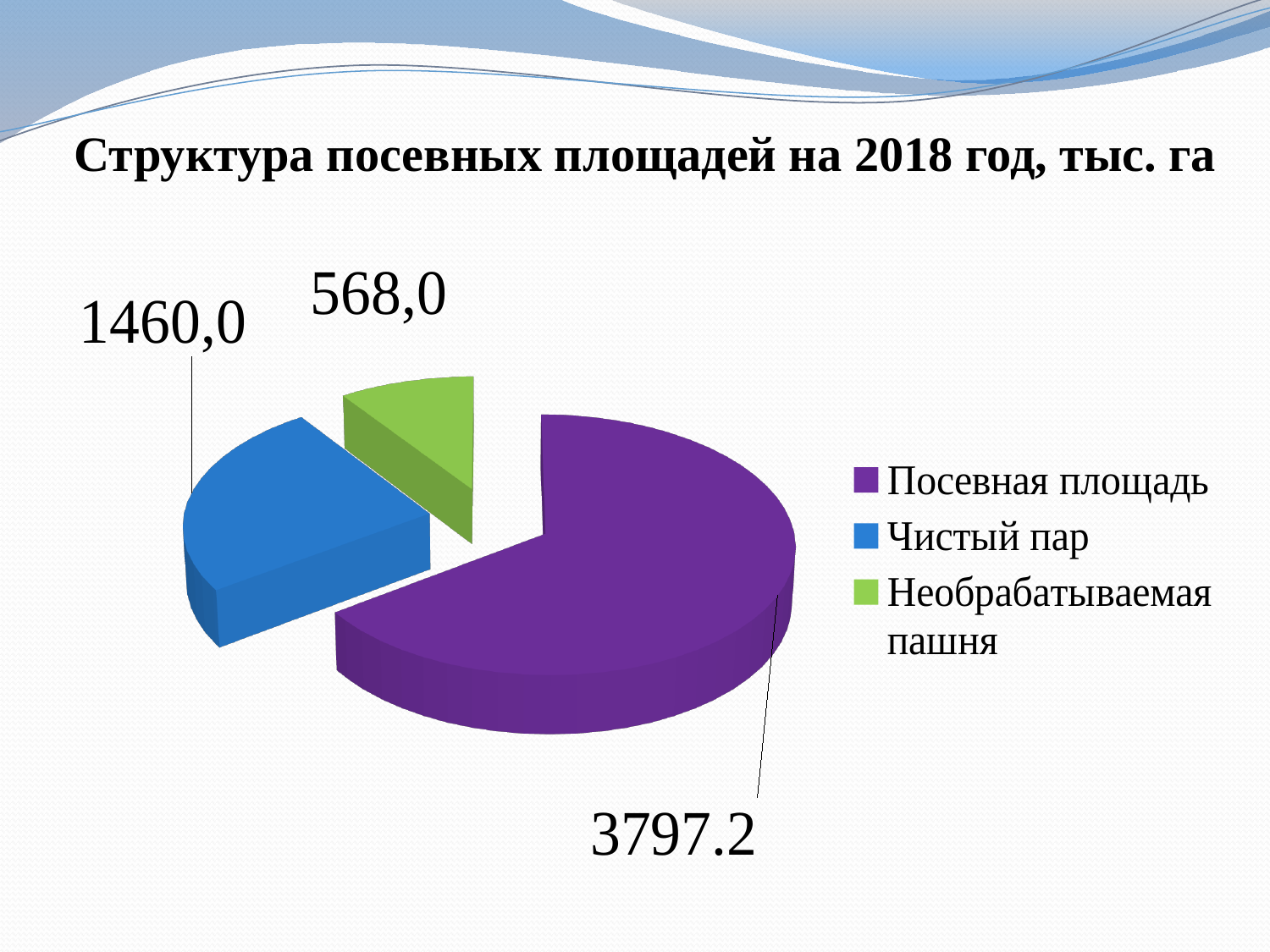
What is the value for Необрабатываемая пашня? 568,0 What colour is the slice for Чистый пар? Blue What is the title of the chart? Структура посевных площадей на 2018 год, тыс. га What is the difference between the values for Посевная площадь and Чистый пар? 2337.2 What is the difference between the values for Чистый пар and Необрабатываемая пашня? 892,0 What is the value for Чистый пар? 1460,0 How many categories does the pie chart show? 3 Which is larger, the value for Чистый пар or the value for Необрабатываемая пашня? Чистый пар What is the value for Посевная площадь? 3797.2 What kind of chart is shown on the slide? Pie chart Which category has the smallest slice of the pie? Необрабатываемая пашня Which category has the largest slice of the pie? Посевная площадь